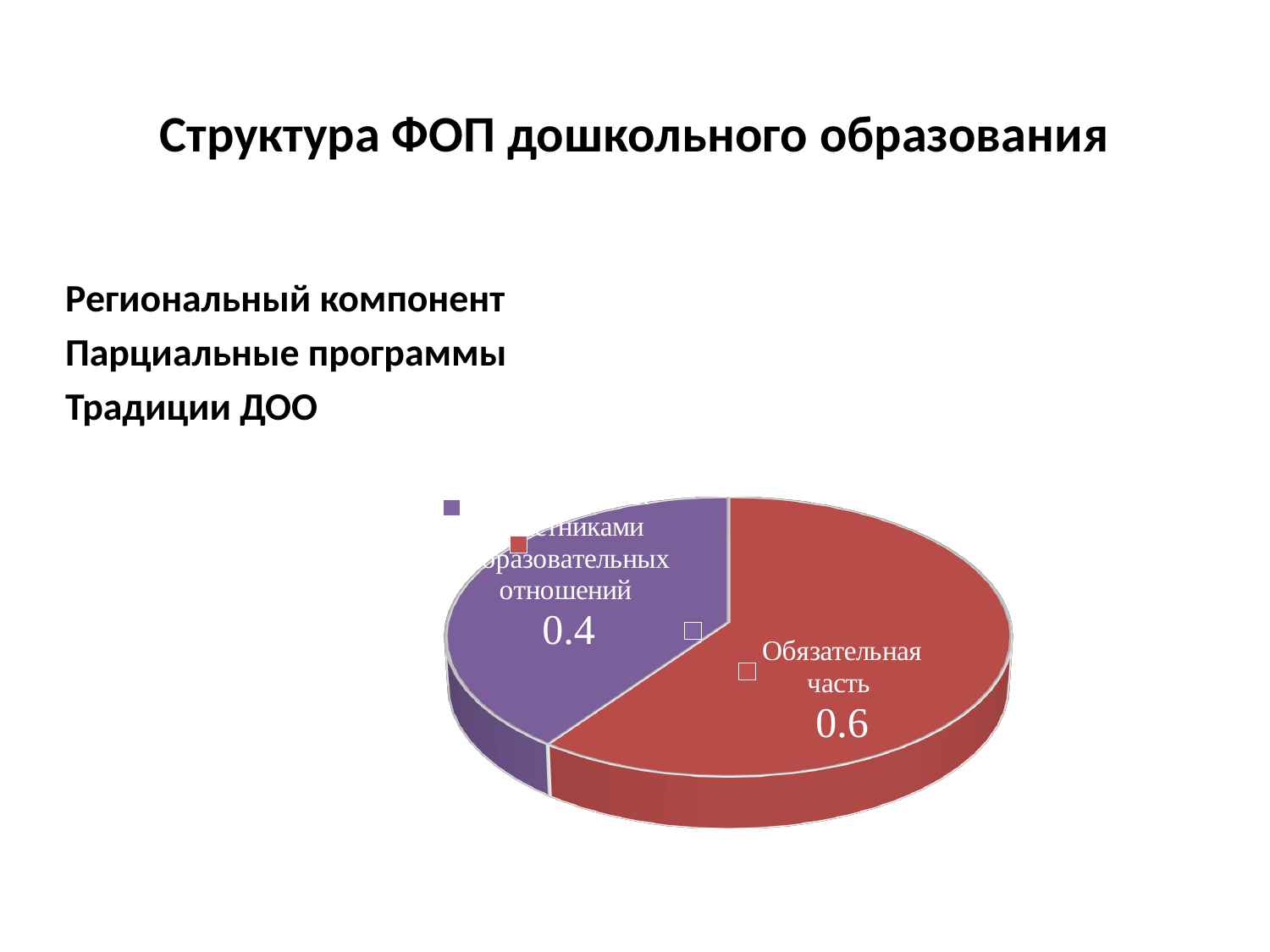
What is the title at the top of the slide? Структура ФОП дошкольного образования How many slices does the pie chart have? 2 What is the difference between the value of "Обязательная часть" and the value of the purple slice? 0.2 What share of the whole pie does "Обязательная часть" represent? 0.6 Which slice of the pie chart is the largest? Обязательная часть Which slice is smaller, the red one or the purple one? the purple one What colour is the slice labeled "Обязательная часть"? red What value is shown for the slice labeled "Обязательная часть"? 0.6 What share of the whole pie does the purple slice represent? 0.4 What value is shown on the purple slice of the pie chart? 0.4 What is the sum of the two values shown on the pie chart? 1.0 What kind of chart is shown on the slide? pie chart